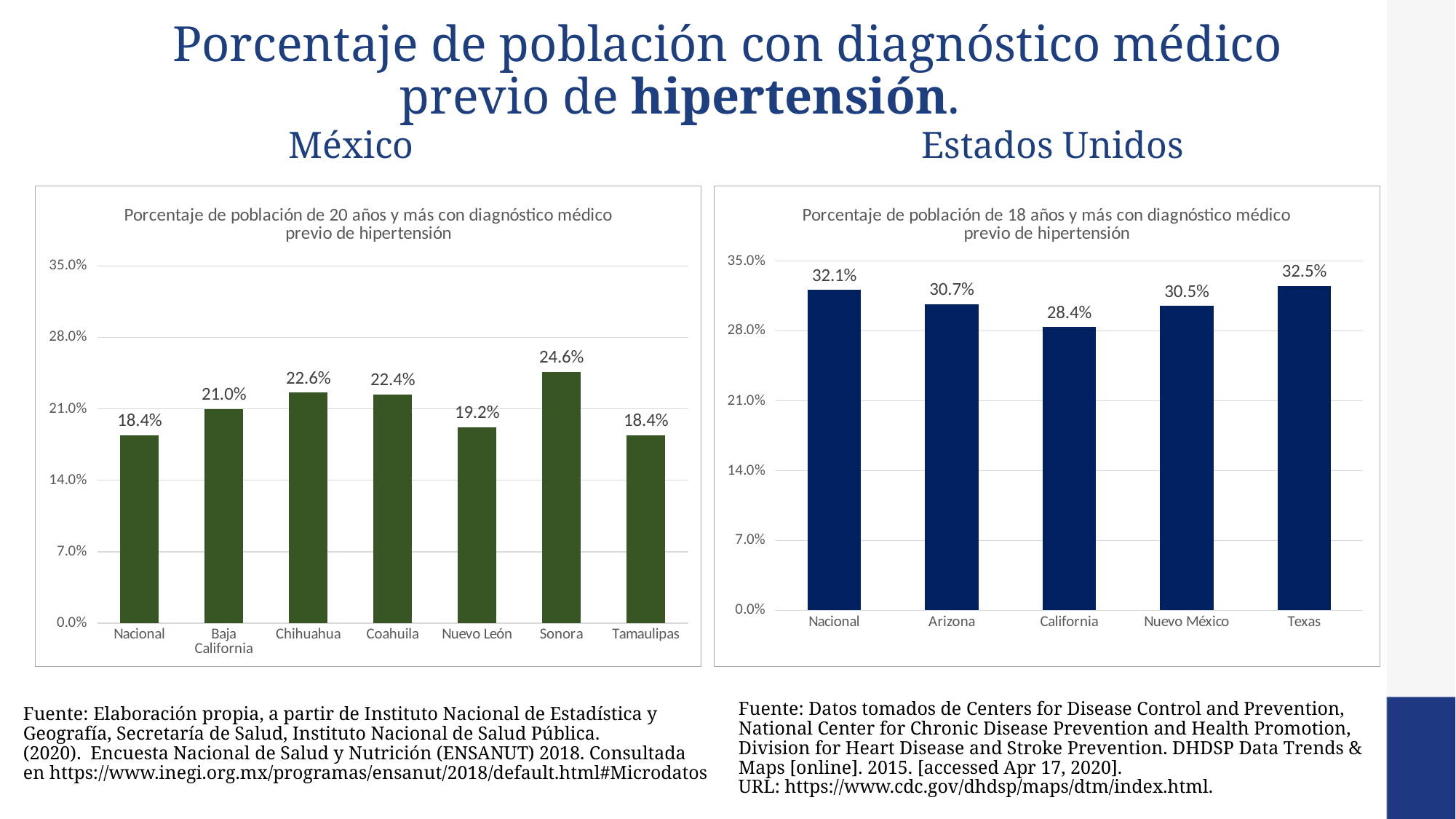
In the Estados Unidos chart, which category has the highest value? Texas In the Estados Unidos chart, is the value for Arizona greater or less than 28.0%? greater In the México chart, which is larger, Chihuahua or Nuevo León? Chihuahua In the México chart, which category has the highest value? Sonora In the México chart, what is the difference between Chihuahua and Nacional? 4.2% In the Estados Unidos chart, what is the value for California? 28.4% How many categories are shown in the Estados Unidos chart? 5 What kind of chart is the Estados Unidos chart? Bar chart In the México chart, what is the value for Sonora? 24.6% In the Estados Unidos chart, which category has the lowest value? California How many categories are shown in the México chart? 7 In the Estados Unidos chart, what is the difference between Texas and California? 4.1%